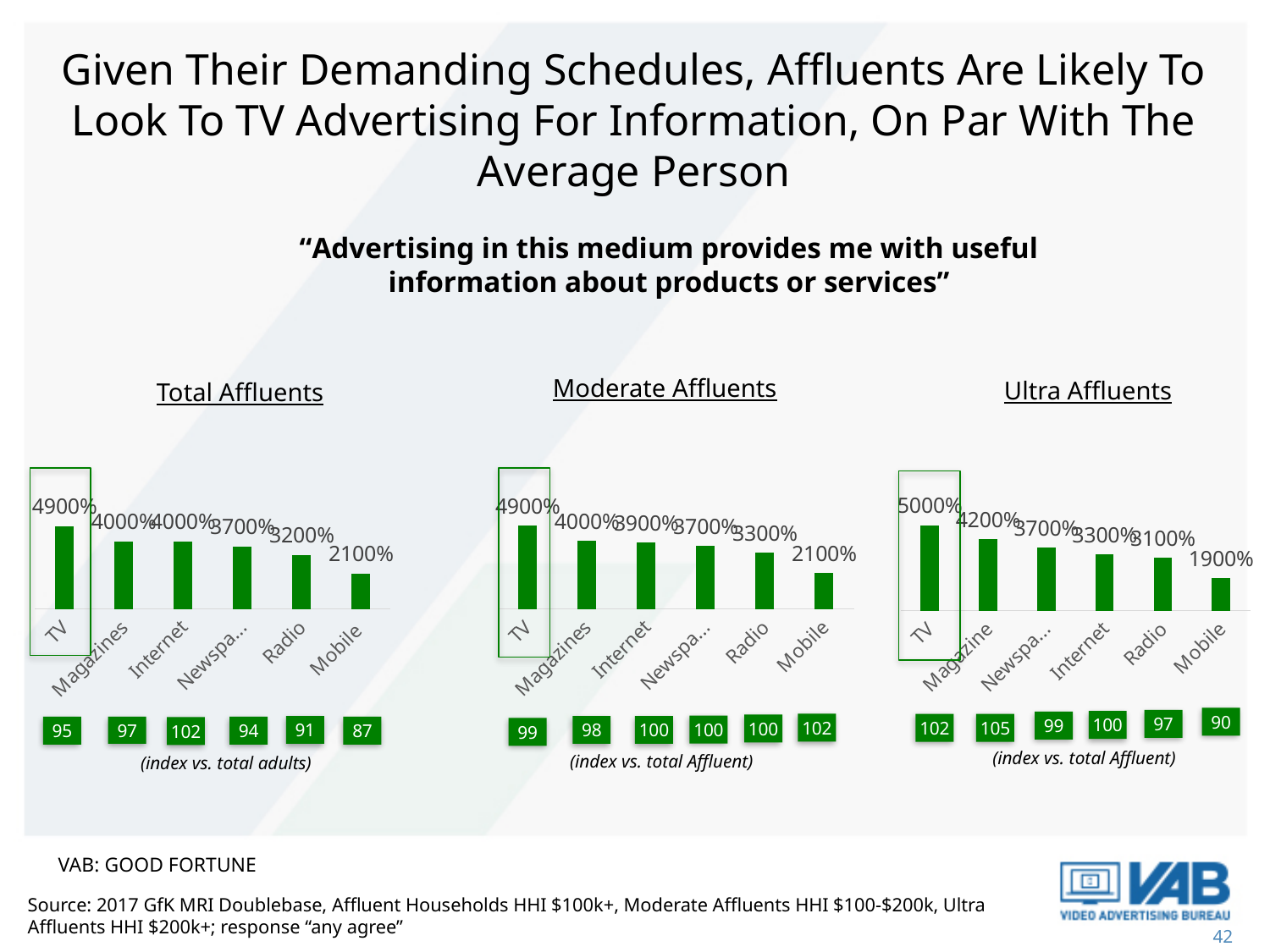
In the Ultra Affluents chart, which category has the highest value? TV In the Total Affluents chart, what is the value for TV? 4900% In the Total Affluents chart, which category has the lowest value? Mobile In the Total Affluents chart, which is larger, the value for Radio or the value for Mobile? Radio In the Ultra Affluents chart, do the values rise or fall from left to right across the categories? Fall What kind of chart is the Total Affluents chart? Bar chart In the Moderate Affluents chart, what is the value for Internet? 3900% How many categories are shown in the Moderate Affluents chart? 6 In the Ultra Affluents chart, what is the value for Mobile? 1900% In the Ultra Affluents chart, what is the difference between the values for Magazine and Radio? 1100% How many charts are shown on the slide? 3 In the Moderate Affluents chart, what is the difference between the values for TV and Mobile? 2800%